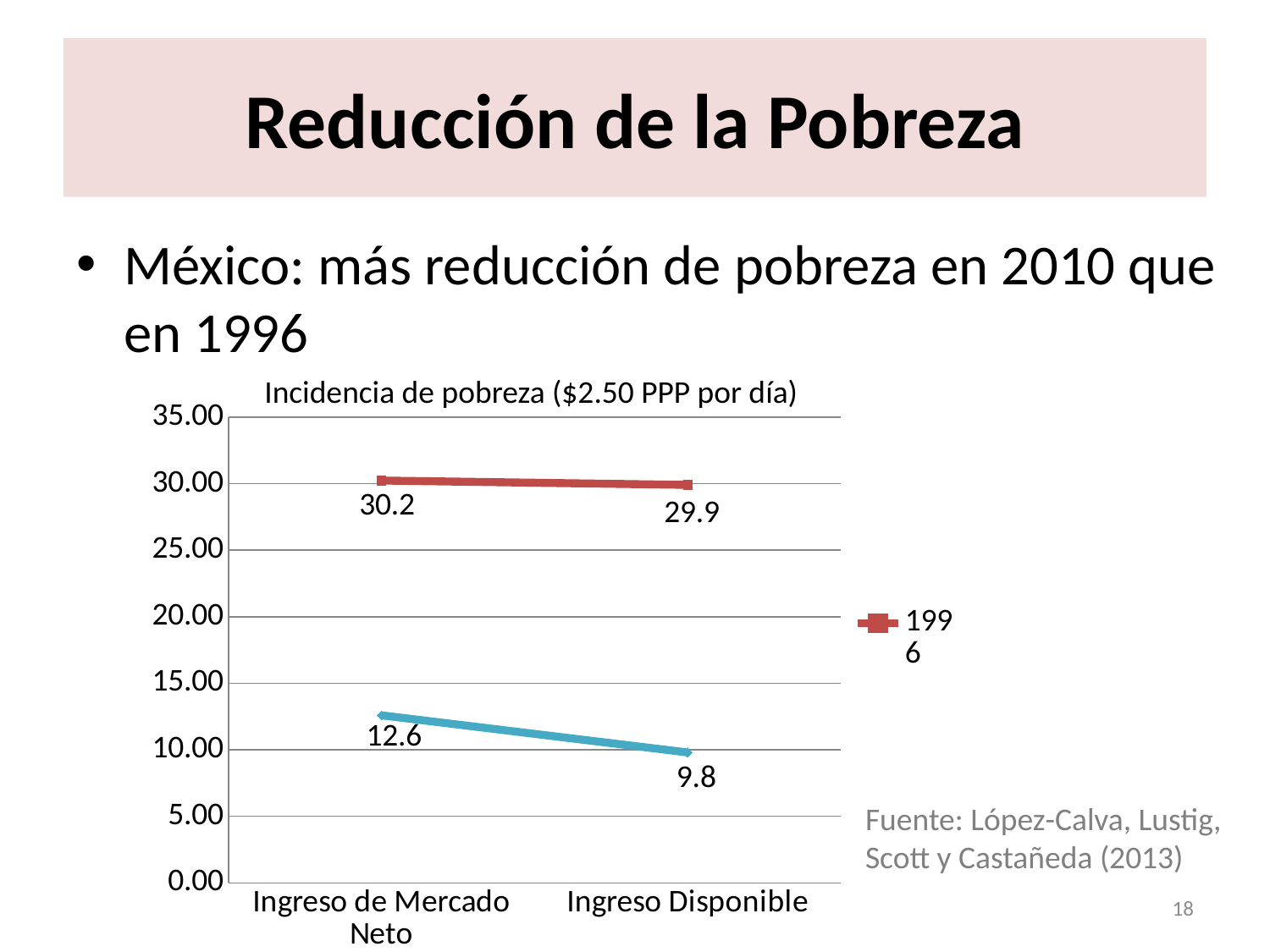
What is the difference between the blue line's values for Ingreso de Mercado Neto and Ingreso Disponible? 2.8 At Ingreso Disponible, what is the difference between the 1996 value and the blue line's value? 20.1 What is the 1996 value for Ingreso Disponible? 29.9 How many categories are shown on the x axis of the chart? 2 What is the 1996 value for Ingreso de Mercado Neto? 30.2 What kind of chart is shown on the slide? line chart At Ingreso Disponible, which is larger: the 1996 value or the blue line's value? 1996 What is the value of the blue line at Ingreso Disponible? 9.8 Is the blue line's value for Ingreso de Mercado Neto greater or less than 15.00? less What is the title of the chart? Incidencia de pobreza ($2.50 PPP por día) What is the value of the blue line at Ingreso de Mercado Neto? 12.6 What is the difference between the 1996 values for Ingreso de Mercado Neto and Ingreso Disponible? 0.3